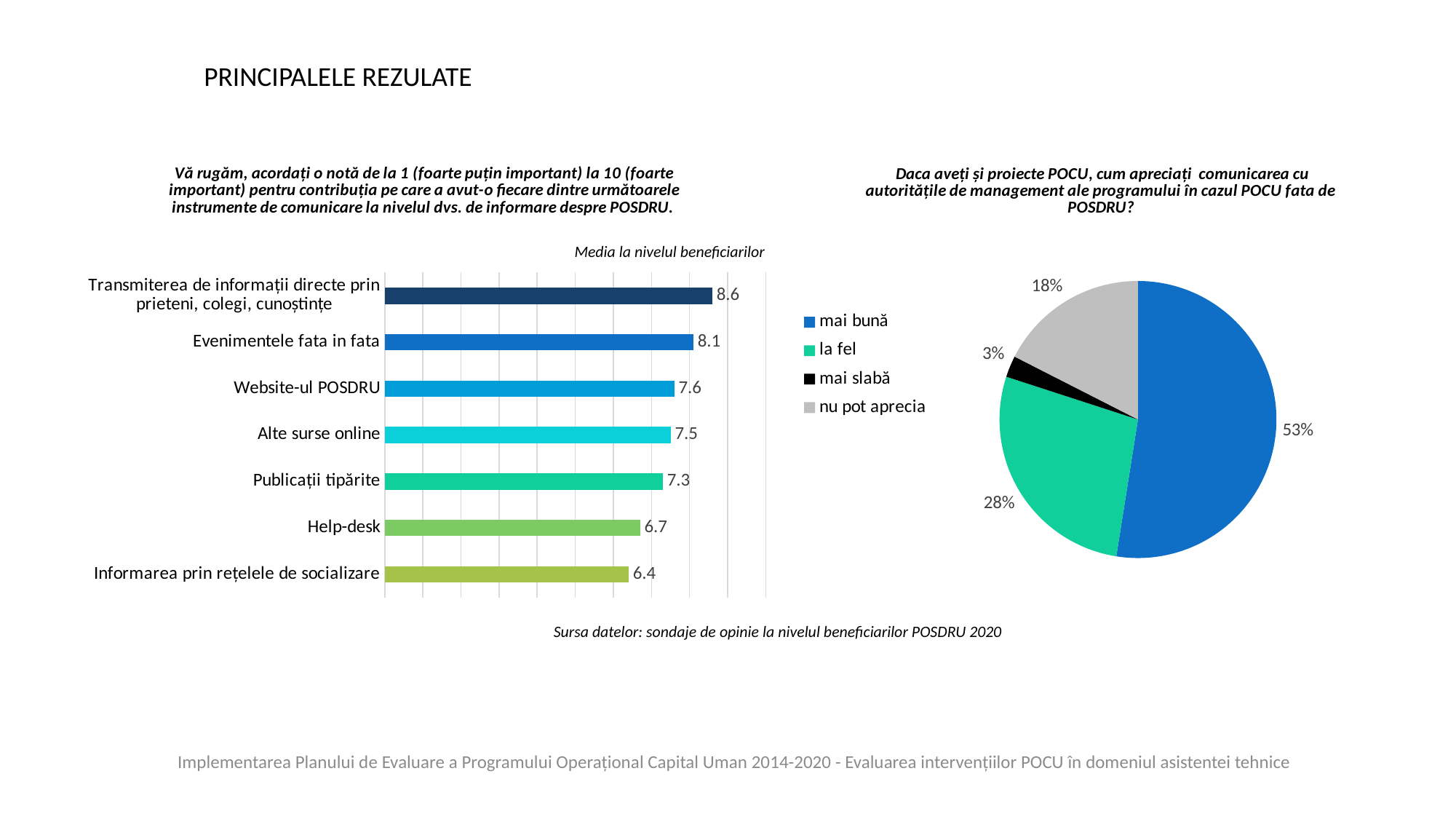
In the bar chart on the left, what is the value for Help-desk? 6.7 How many categories does the bar chart on the left show? 7 In the bar chart on the left, what is the value for Website-ul POSDRU? 7.6 In the bar chart on the left, which is larger: Alte surse online or Help-desk? Alte surse online In the bar chart on the left, what is the difference between Evenimentele fata in fata and Publicații tipărite? 0.8 In the pie chart on the right, which slice is the smallest? mai slabă How many entries does the legend of the pie chart on the right list? 4 In the pie chart on the right, what share does 'la fel' have? 28% What kind of chart is the chart on the left? Bar chart In the bar chart on the left, which category has the highest value? Transmiterea de informații directe prin prieteni, colegi, cunoștințe In the bar chart on the left, which category has the lowest value? Informarea prin rețelele de socializare In the pie chart on the right, what is the difference between the 'mai bună' and 'nu pot aprecia' shares? 35%